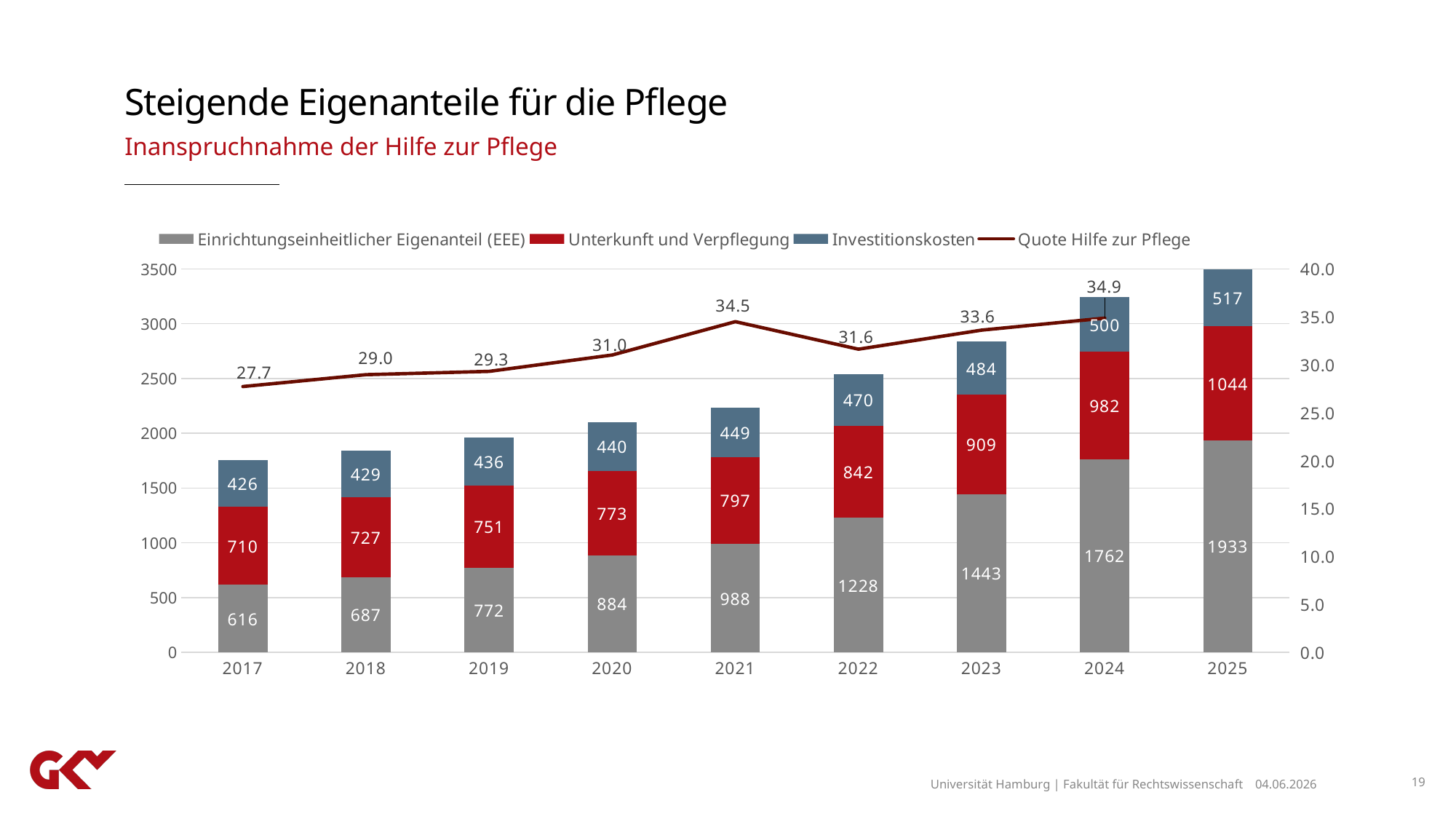
What is the value of Unterkunft und Verpflegung for 2019? 751 What is the value of Investitionskosten for 2025? 517 How many years are shown on the x axis? 9 Which year has the higher Quote Hilfe zur Pflege, 2022 or 2023? 2023 How many series does the legend list? 4 What is the Quote Hilfe zur Pflege value shown for 2021? 34.5 By how much does the Einrichtungseinheitlicher Eigenanteil (EEE) in 2025 exceed that in 2017? 1317 Does the Einrichtungseinheitlicher Eigenanteil (EEE) rise or fall from 2017 to 2025? rise In which year is the Investitionskosten value lowest? 2017 In which year is the Einrichtungseinheitlicher Eigenanteil (EEE) highest? 2025 What is the value of Einrichtungseinheitlicher Eigenanteil (EEE) for 2022? 1228 What is the total of the stacked bar for 2017? 1752